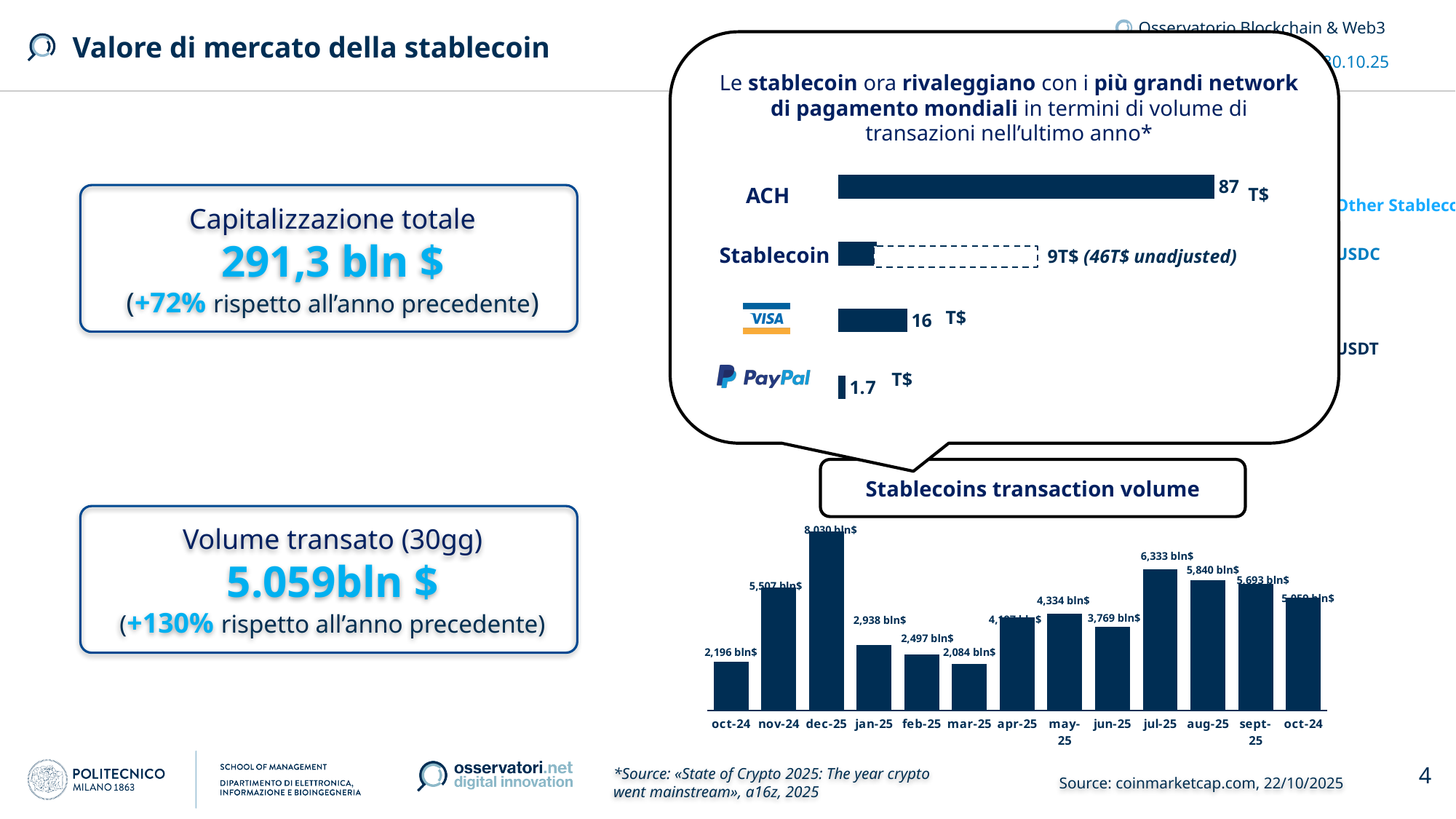
In the chart comparing payment networks in the speech bubble, what is the difference between the ACH volume and the Visa volume? 71 T$ What kind of chart is the 'Stablecoins transaction volume' chart? bar chart In the chart comparing payment networks in the speech bubble, what is the transaction volume for PayPal? 1.7 T$ In the chart comparing payment networks in the speech bubble, what is the transaction volume for Visa? 16 T$ In the chart comparing payment networks in the speech bubble, what is the unadjusted transaction volume shown for Stablecoin? 46T$ In the 'Stablecoins transaction volume' chart, which month has the highest value? dec-25 In the 'Stablecoins transaction volume' chart, what is the value for nov-24? 5,507 bln$ In the 'Stablecoins transaction volume' chart, what is the difference between jul-25 and aug-25? 493 bln$ In the 'Stablecoins transaction volume' chart, what is the value for mar-25? 2,084 bln$ In the chart comparing payment networks in the speech bubble, which network has the lowest transaction volume? PayPal In the chart comparing payment networks in the speech bubble, which network has the highest transaction volume? ACH In the chart comparing payment networks in the speech bubble, what is the transaction volume for ACH? 87 T$